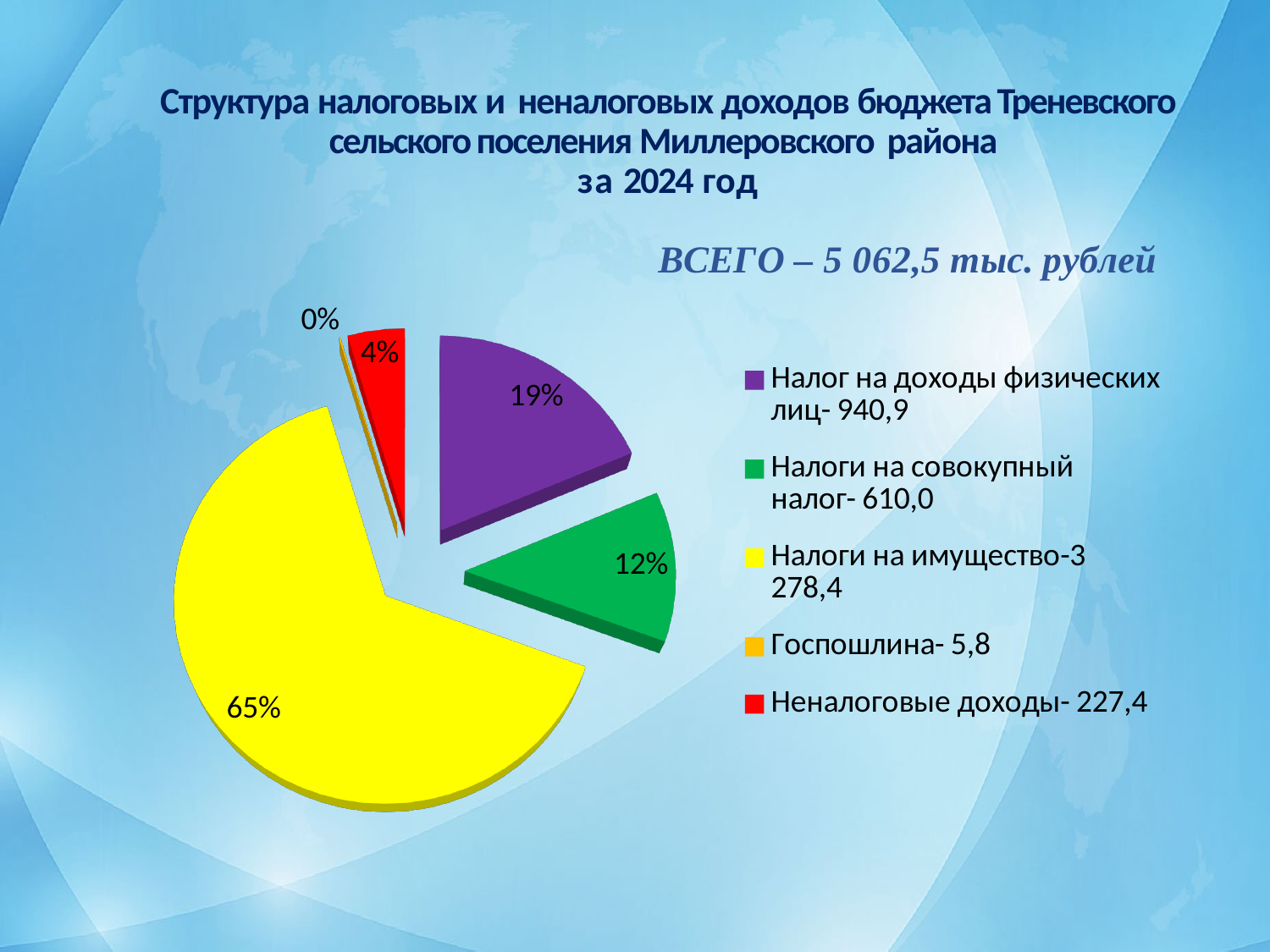
What share of the pie does Налог на доходы физических лиц take? 19% What kind of chart is shown on the slide? pie chart What share of the pie does Неналоговые доходы take? 4% What share of the pie does Налоги на совокупный налог take? 12% Which category has the largest slice of the pie? Налоги на имущество Which category has the smallest slice of the pie? Госпошлина What colour is the slice for Налоги на имущество? yellow How many categories does the pie chart have? 5 What is the difference in percentage points between the share for Налоги на имущество and the share for Налог на доходы физических лиц? 46 Which is larger: the share for Налог на доходы физических лиц or the share for Неналоговые доходы? Налог на доходы физических лиц